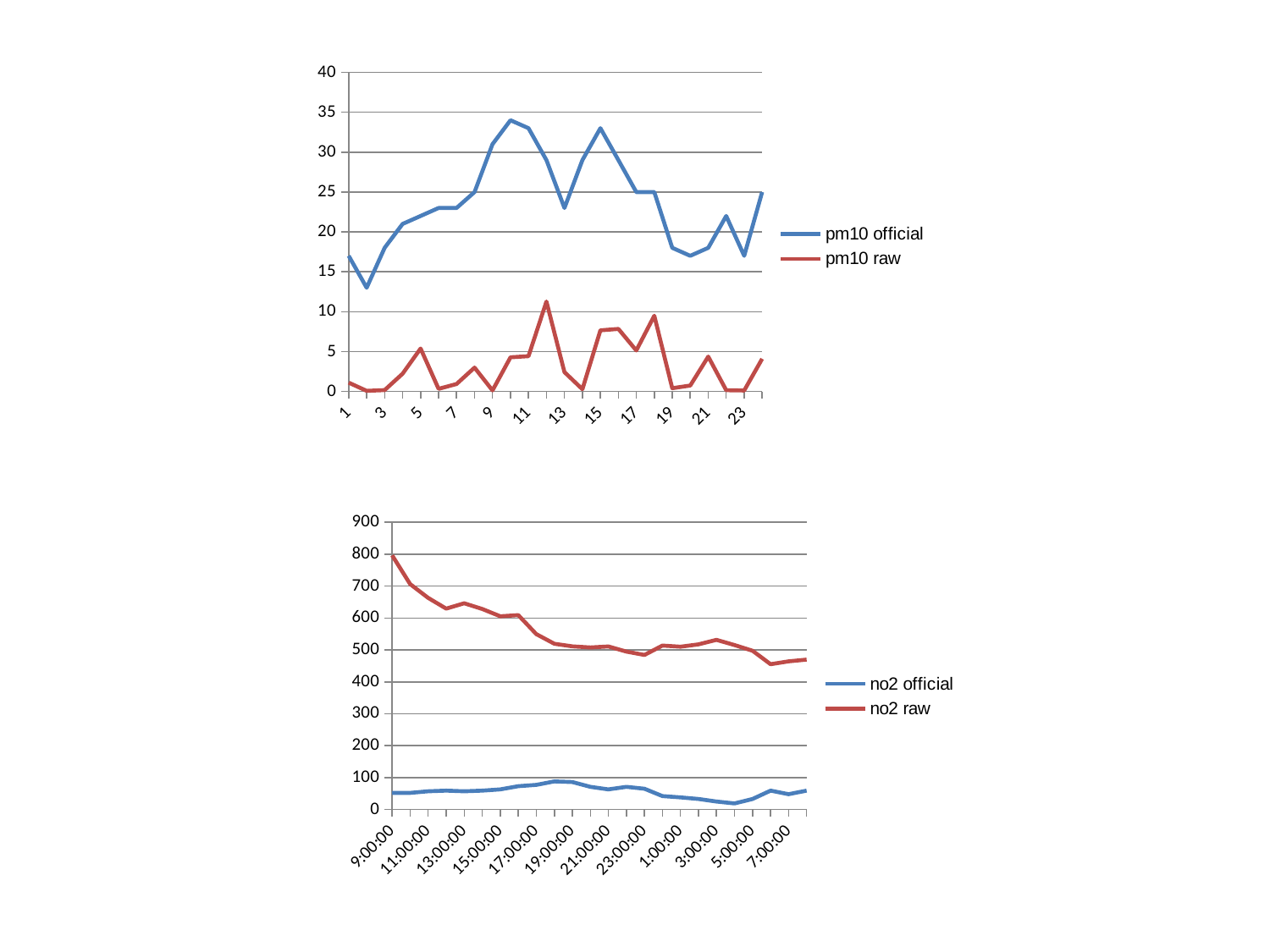
In the bottom chart, is the value of no2 raw at 9:00:00 greater or less than 700? greater How many series does the legend of the bottom chart list? 2 How many series does the legend of the top chart list? 2 In the bottom chart, what are the two legend entries? no2 official, no2 raw In the top chart, which series is plotted in red? pm10 raw In the bottom chart, does the no2 raw series generally rise or fall from 9:00:00 to 7:00:00? fall In the top chart, which series has higher values throughout, pm10 official or pm10 raw? pm10 official In the top chart, is the value of pm10 official at x = 10 greater or less than 30? greater In the top chart, is the value of pm10 raw at x = 12 greater or less than 5? greater What kind of chart is the top chart on the slide? line chart What kind of chart is the bottom chart on the slide? line chart